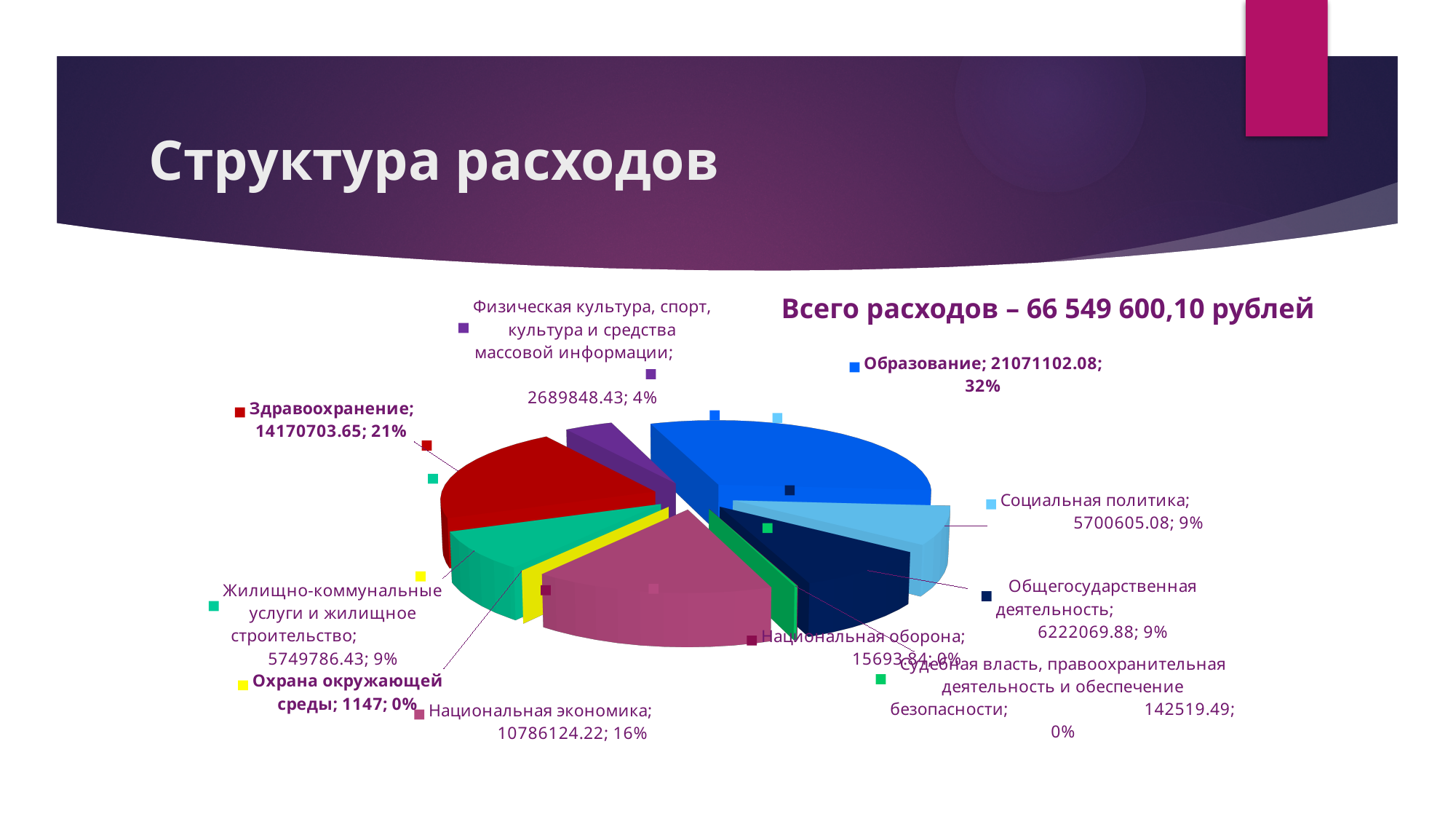
How many categories are shown in the pie chart? 10 What share of the pie does Национальная экономика represent? 16% What is the value shown for Национальная экономика? 10786124.22 What is the value shown for Здравоохранение? 14170703.65 What is the difference between the values for Образование and Здравоохранение? 6900398.43 What is the value shown for Жилищно-коммунальные услуги и жилищное строительство? 5749786.43 Which is larger, the value for Здравоохранение or the value for Национальная экономика? Здравоохранение What type of chart is shown on the slide? Pie chart What is the value shown for Образование? 21071102.08 Which category has the largest value in the pie chart? Образование Which category has the smallest value in the pie chart? Охрана окружающей среды What share of the pie does Физическая культура, спорт, культура и средства массовой информации represent? 4%